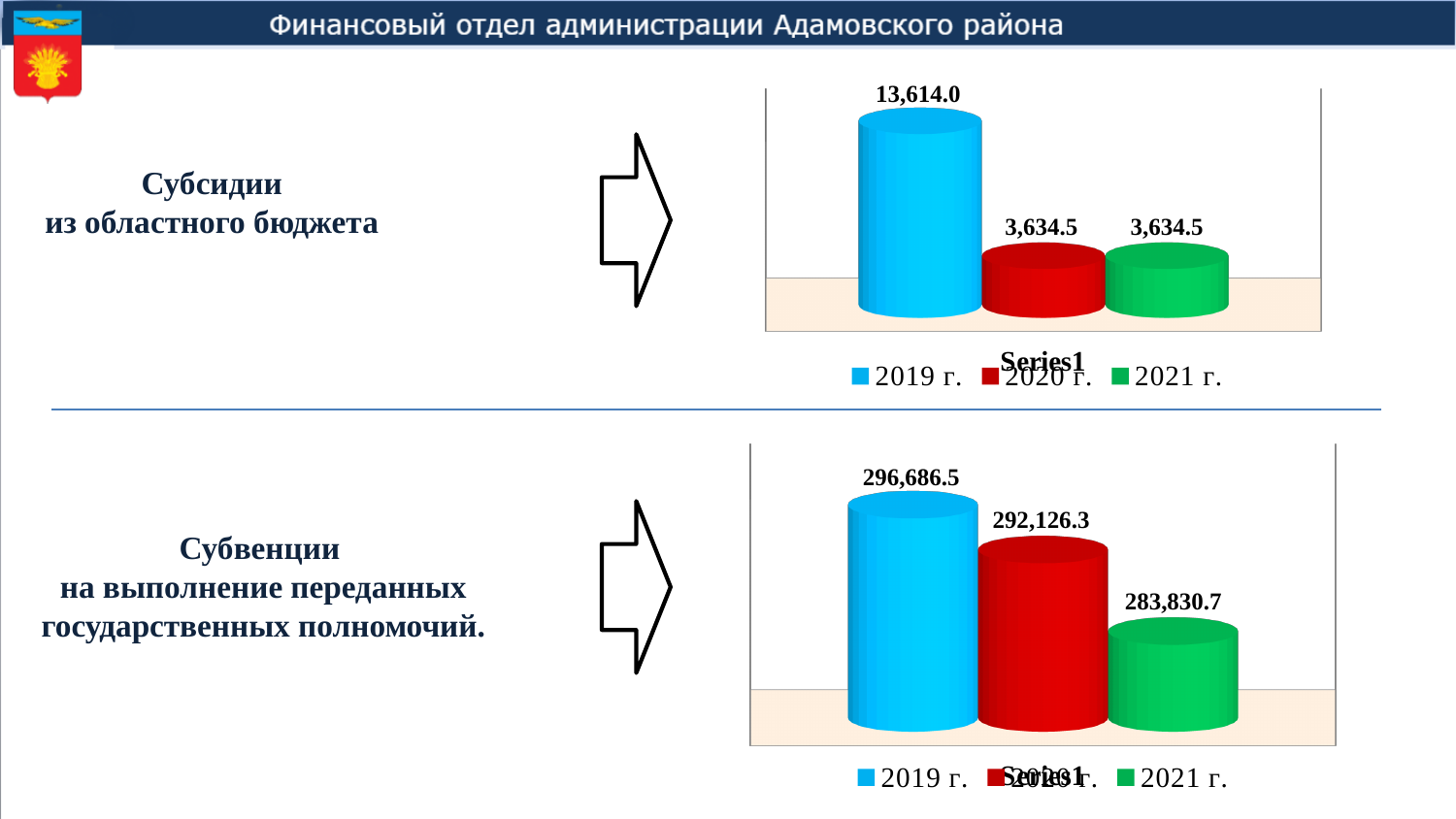
In the top chart (Субсидии из областного бюджета), which year has the highest value? 2019 г. In the bottom chart (Субвенции на выполнение переданных государственных полномочий), which year has the lowest value? 2021 г. In the top chart (Субсидии из областного бюджета), what is the value for 2020 г.? 3,634.5 In the top chart (Субсидии из областного бюджета), how many bars are plotted? 3 In the bottom chart (Субвенции на выполнение переданных государственных полномочий), what is the value for 2021 г.? 283,830.7 In the bottom chart (Субвенции на выполнение переданных государственных полномочий), do the values rise or fall from 2019 г. to 2021 г.? fall In the bottom chart (Субвенции на выполнение переданных государственных полномочий), what is the value for 2020 г.? 292,126.3 In the bottom chart (Субвенции на выполнение переданных государственных полномочий), what is the difference between the 2019 г. value and the 2021 г. value? 12,855.8 What type of chart is the top chart (Субсидии из областного бюджета)? bar chart In the top chart (Субсидии из областного бюджета), what is the difference between the 2019 г. value and the 2020 г. value? 9,979.5 In the top chart (Субсидии из областного бюджета), what is the value for 2019 г.? 13,614.0 How many entries does the legend of the bottom chart list? 3